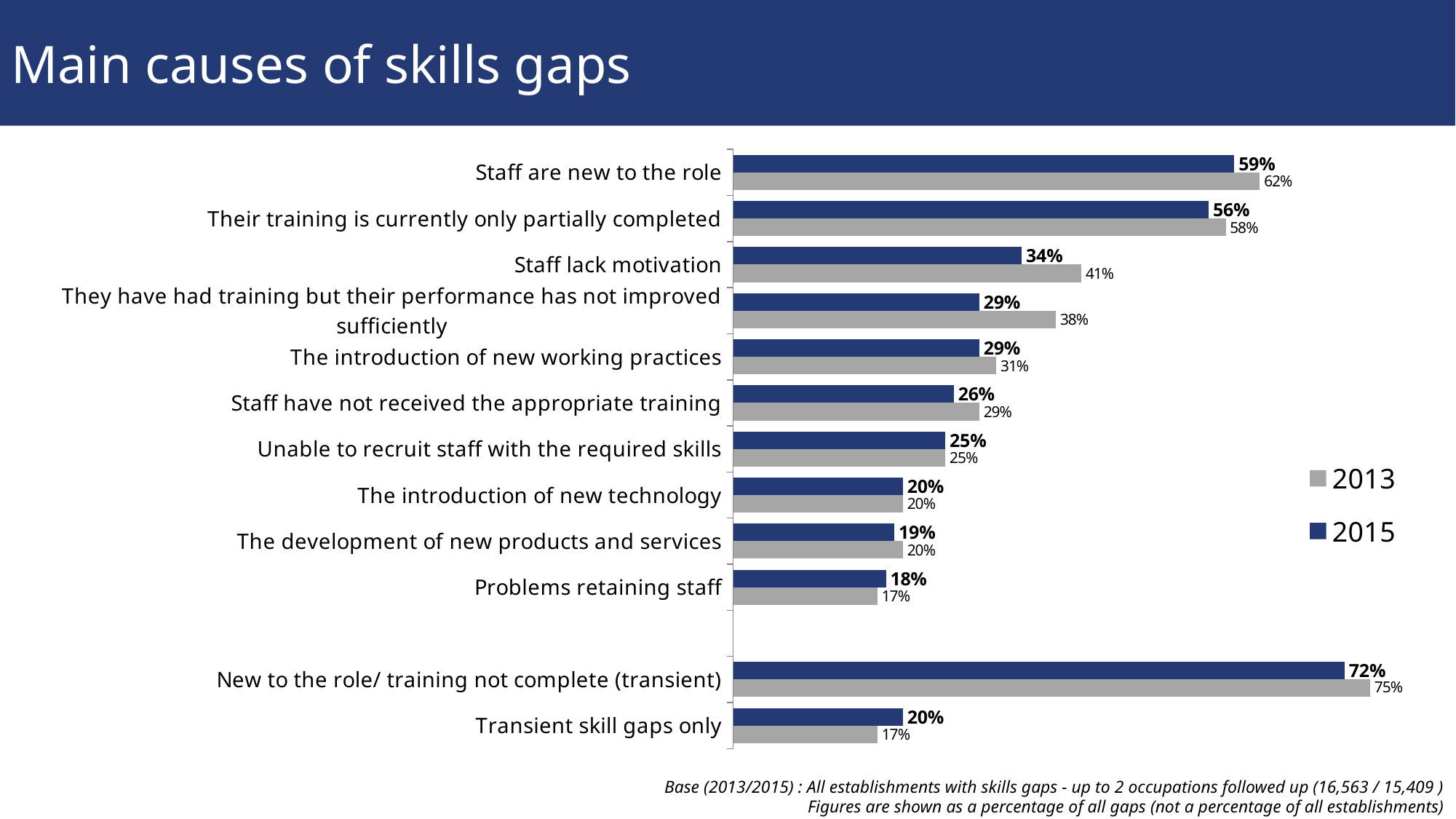
What is the 2015 value for 'Staff lack motivation'? 34% Which category has the highest 2013 value? New to the role/ training not complete (transient) What is the 2013 value for 'Staff are new to the role'? 62% What is the 2015 value for 'New to the role/ training not complete (transient)'? 72% How many categories are shown on the chart? 12 What is the difference between the 2013 and 2015 values for 'Staff lack motivation'? 7% What kind of chart is shown on the slide? bar chart Which is larger for 'Transient skill gaps only': the 2013 value or the 2015 value? 2015 Which colour represents the 2013 series in the legend? grey What is the 2013 value for 'They have had training but their performance has not improved sufficiently'? 38% Which category has the lowest 2015 value? Problems retaining staff How many series does the legend list? 2